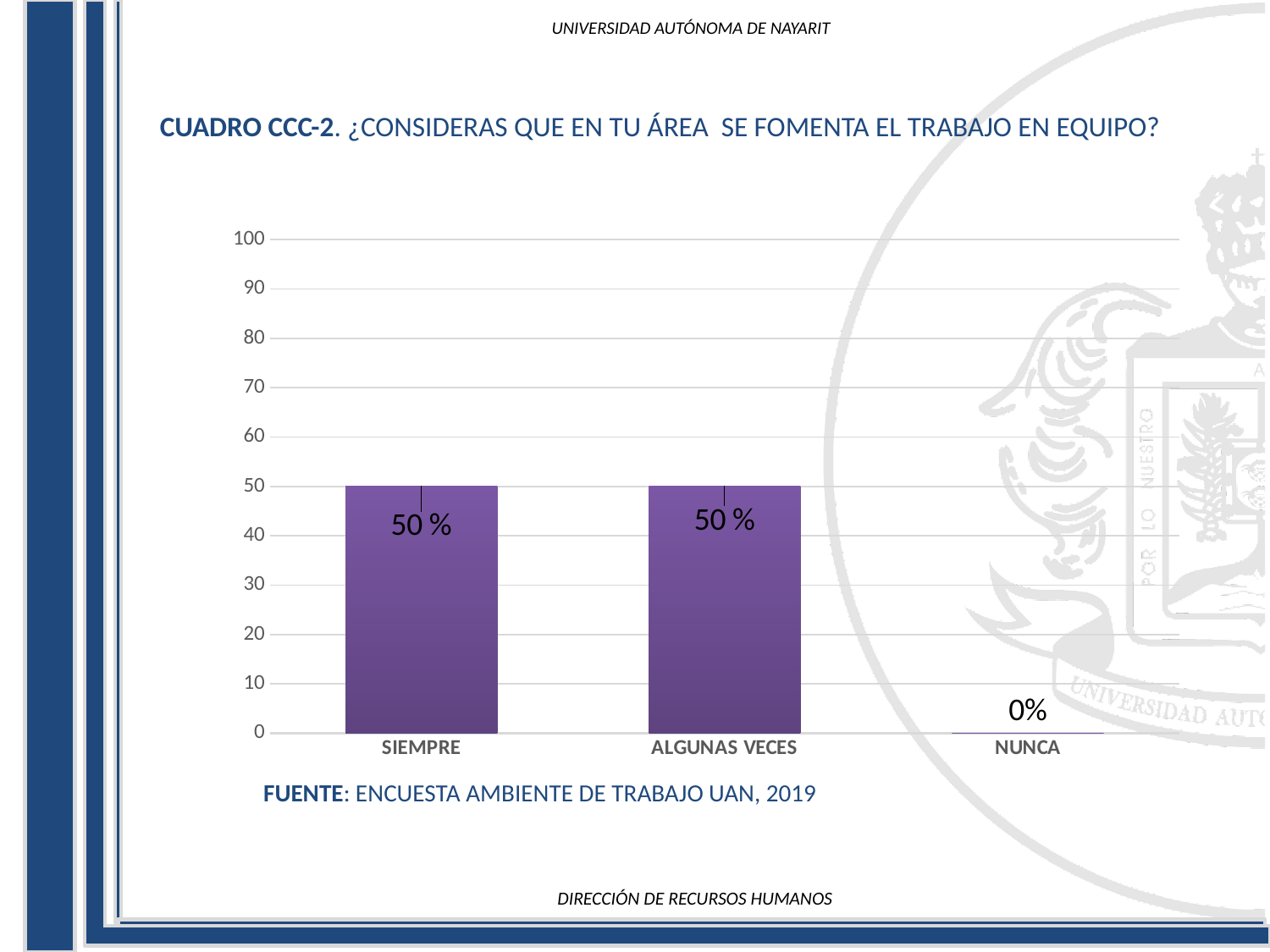
Is the value for SIEMPRE greater or less than 40? greater Do the values rise or fall from SIEMPRE to NUNCA along the x axis? fall What kind of chart is shown on the slide? bar chart Which category has the lowest value? NUNCA What is the value for SIEMPRE? 50 % What source is cited below the chart? ENCUESTA AMBIENTE DE TRABAJO UAN, 2019 Is the value for ALGUNAS VECES greater or less than 80? less How many categories are shown on the x axis? 3 What is the value for NUNCA? 0% Which is larger, the value for SIEMPRE or the value for NUNCA? SIEMPRE What is the value for ALGUNAS VECES? 50 % What is the difference between the value for ALGUNAS VECES and the value for NUNCA? 50 %